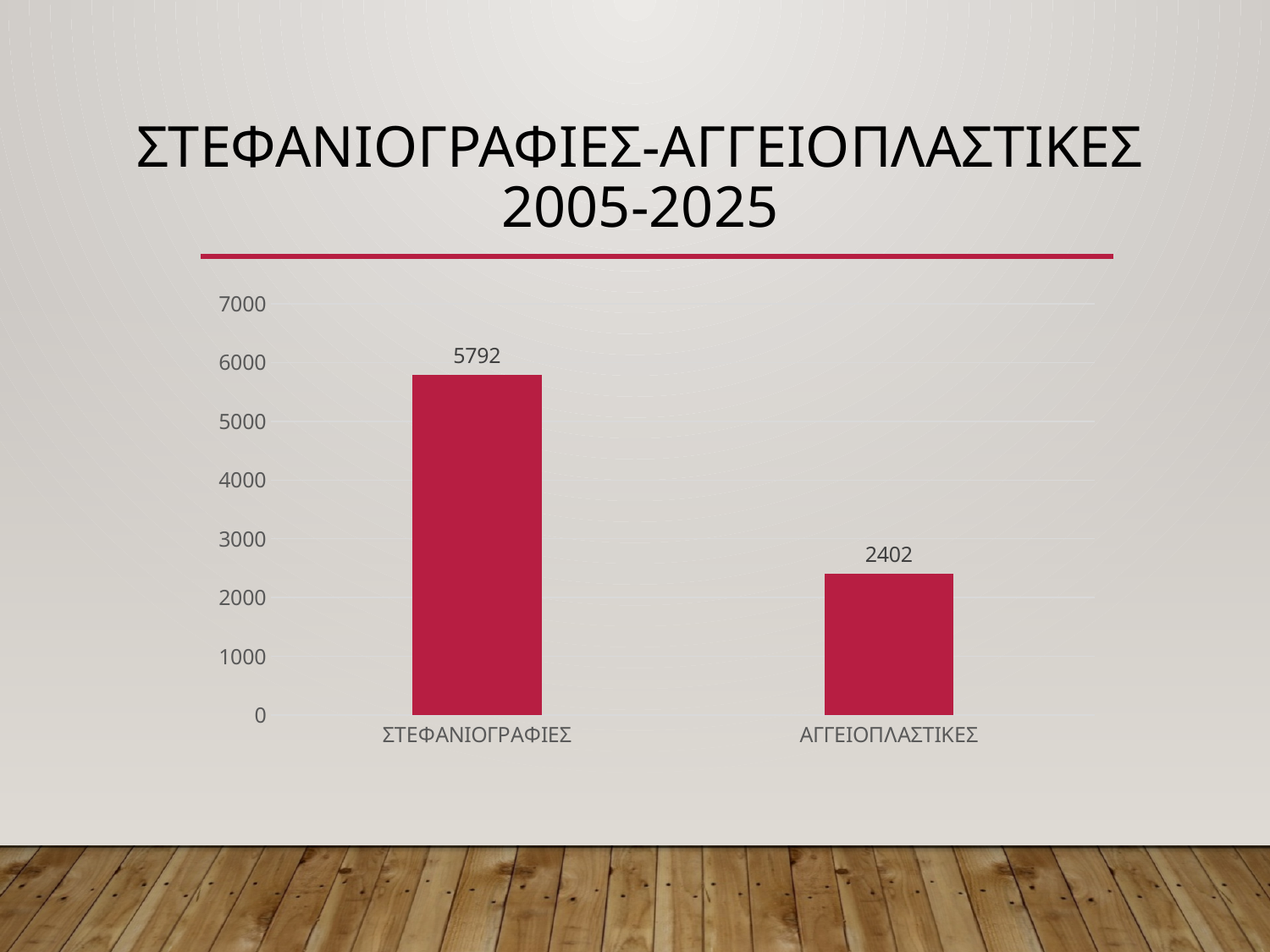
Which is larger, the value for ΣΤΕΦΑΝΙΟΓΡΑΦΙΕΣ or the value for ΑΓΓΕΙΟΠΛΑΣΤΙΚΕΣ? ΣΤΕΦΑΝΙΟΓΡΑΦΙΕΣ What kind of chart is shown on the slide? bar chart Which category has the lowest value? ΑΓΓΕΙΟΠΛΑΣΤΙΚΕΣ What is the total of the two values shown in the chart? 8194 How many categories are shown in the chart? 2 What is the title of the slide? ΣΤΕΦΑΝΙΟΓΡΑΦΙΕΣ-ΑΓΓΕΙΟΠΛΑΣΤΙΚΕΣ 2005-2025 What is the value for ΑΓΓΕΙΟΠΛΑΣΤΙΚΕΣ? 2402 Which category has the highest value? ΣΤΕΦΑΝΙΟΓΡΑΦΙΕΣ Is the value for ΑΓΓΕΙΟΠΛΑΣΤΙΚΕΣ greater or less than 3000? less Is the value for ΣΤΕΦΑΝΙΟΓΡΑΦΙΕΣ greater or less than 5000? greater What is the value for ΣΤΕΦΑΝΙΟΓΡΑΦΙΕΣ? 5792 What is the difference between the values for ΣΤΕΦΑΝΙΟΓΡΑΦΙΕΣ and ΑΓΓΕΙΟΠΛΑΣΤΙΚΕΣ? 3390